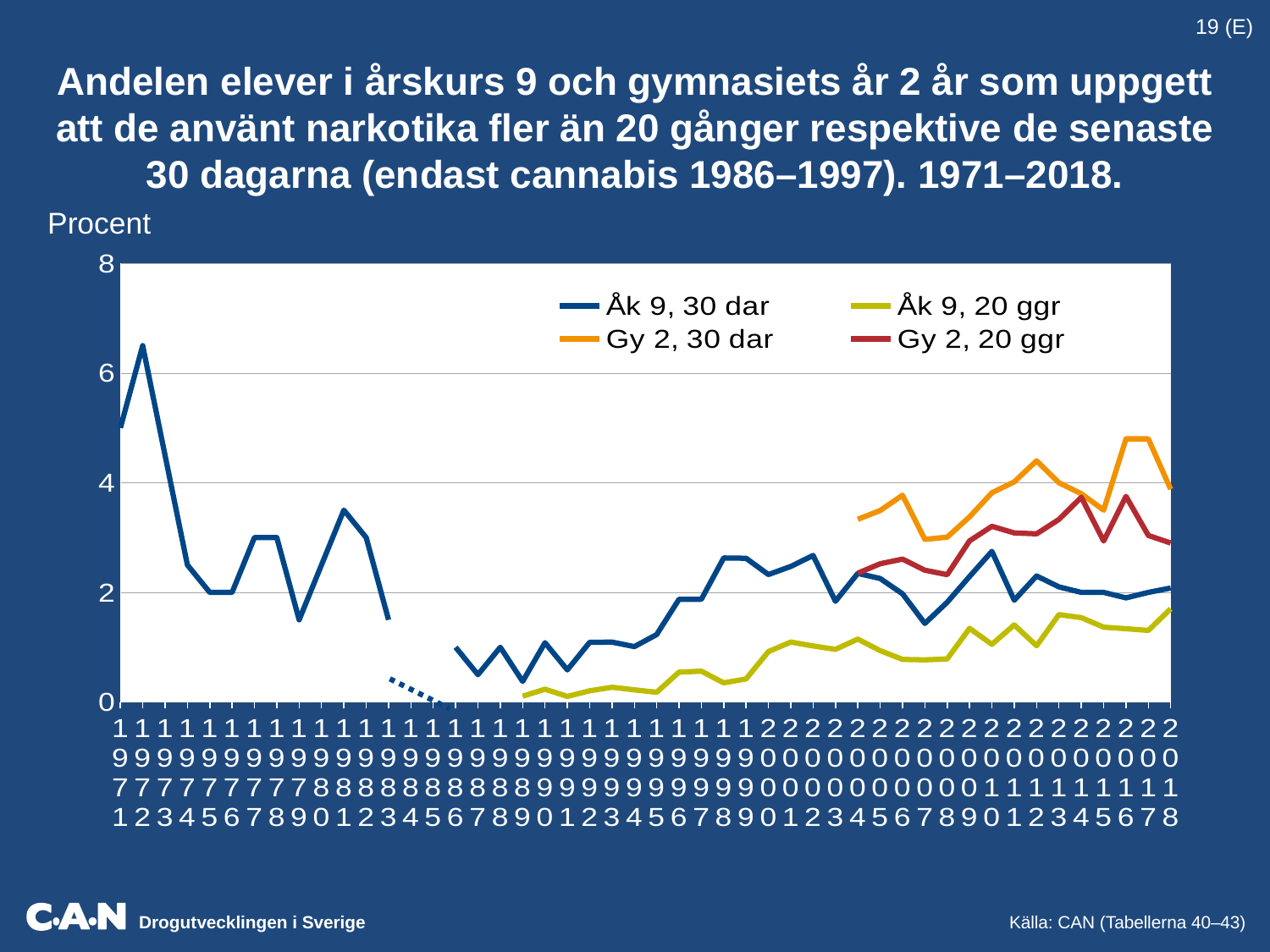
Which series has the highest value in 2018? Gy 2, 30 dar Is the peak value of the Åk 9, 30 dar series greater or less than 6? greater Which series are listed in the legend? Åk 9, 30 dar; Gy 2, 30 dar; Åk 9, 20 ggr; Gy 2, 20 ggr In 2018, which is larger: Gy 2, 20 ggr or Åk 9, 30 dar? Gy 2, 20 ggr What kind of chart is shown on the slide? line chart Is the highest value of the Gy 2, 30 dar series greater or less than 4? greater How many series does the legend list? 4 Does the Gy 2, 30 dar series overall rise or fall from its first year to 2018? rise Is the value for Åk 9, 20 ggr in 2018 greater or less than 2? less Does the Åk 9, 30 dar series overall rise or fall between 1971 and the mid-1980s? fall What unit label is shown above the vertical axis? Procent Which series has the lowest value in 2018? Åk 9, 20 ggr